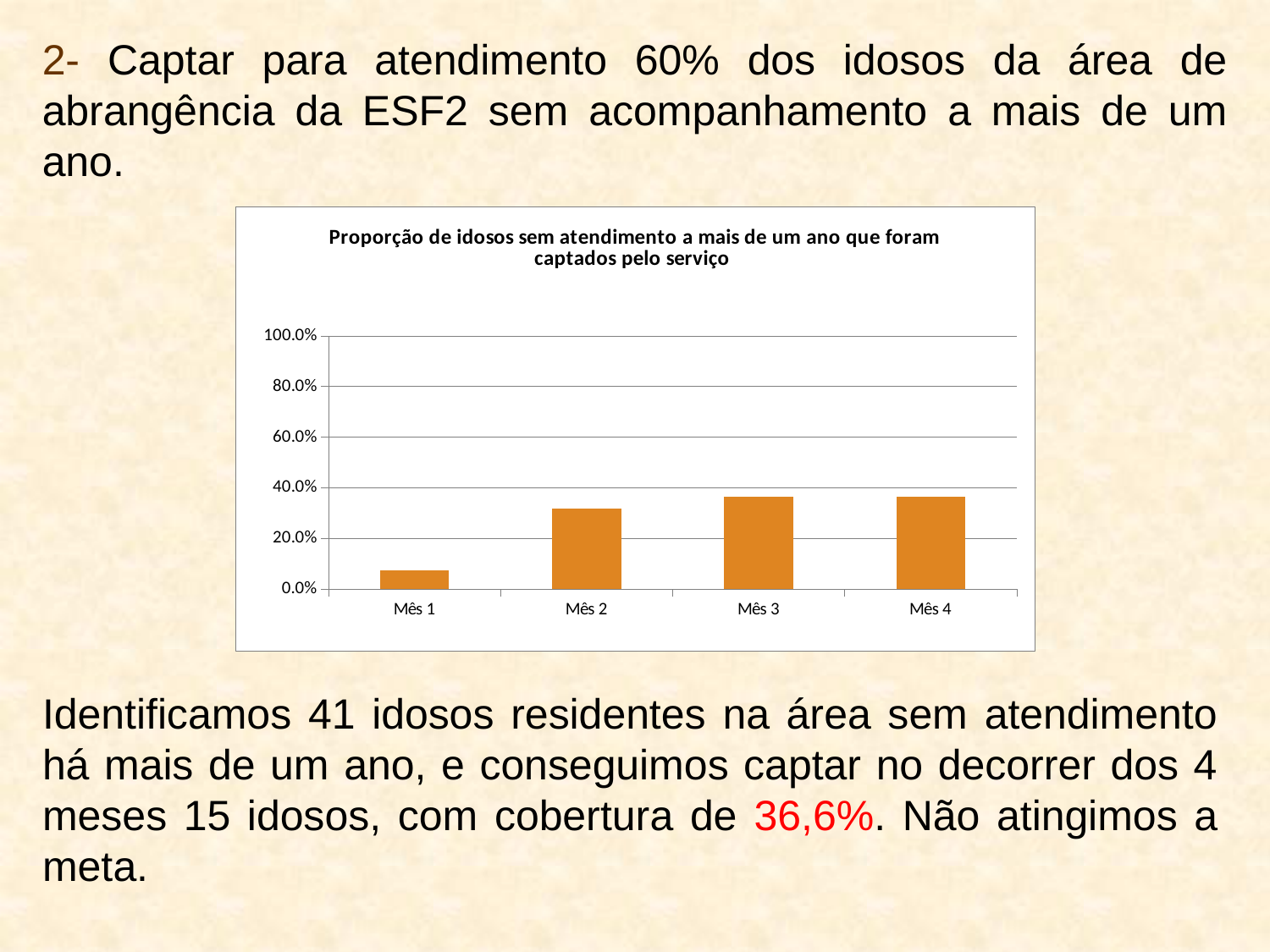
Is the value for Mês 4 greater or less than 60.0%? less What is the title of the chart? Proporção de idosos sem atendimento a mais de um ano que foram captados pelo serviço What kind of chart is shown on the slide? bar chart Do the values generally rise or fall from Mês 1 to Mês 4? rise Which month has the lowest proportion in the chart? Mês 1 Is the value for Mês 3 greater or less than 40.0%? less How many months (categories) are shown on the x axis of the chart? 4 Is the value for Mês 2 greater or less than 20.0%? greater What is the highest value shown on the y axis of the chart? 100.0% Which is larger, the value for Mês 1 or the value for Mês 2? Mês 2